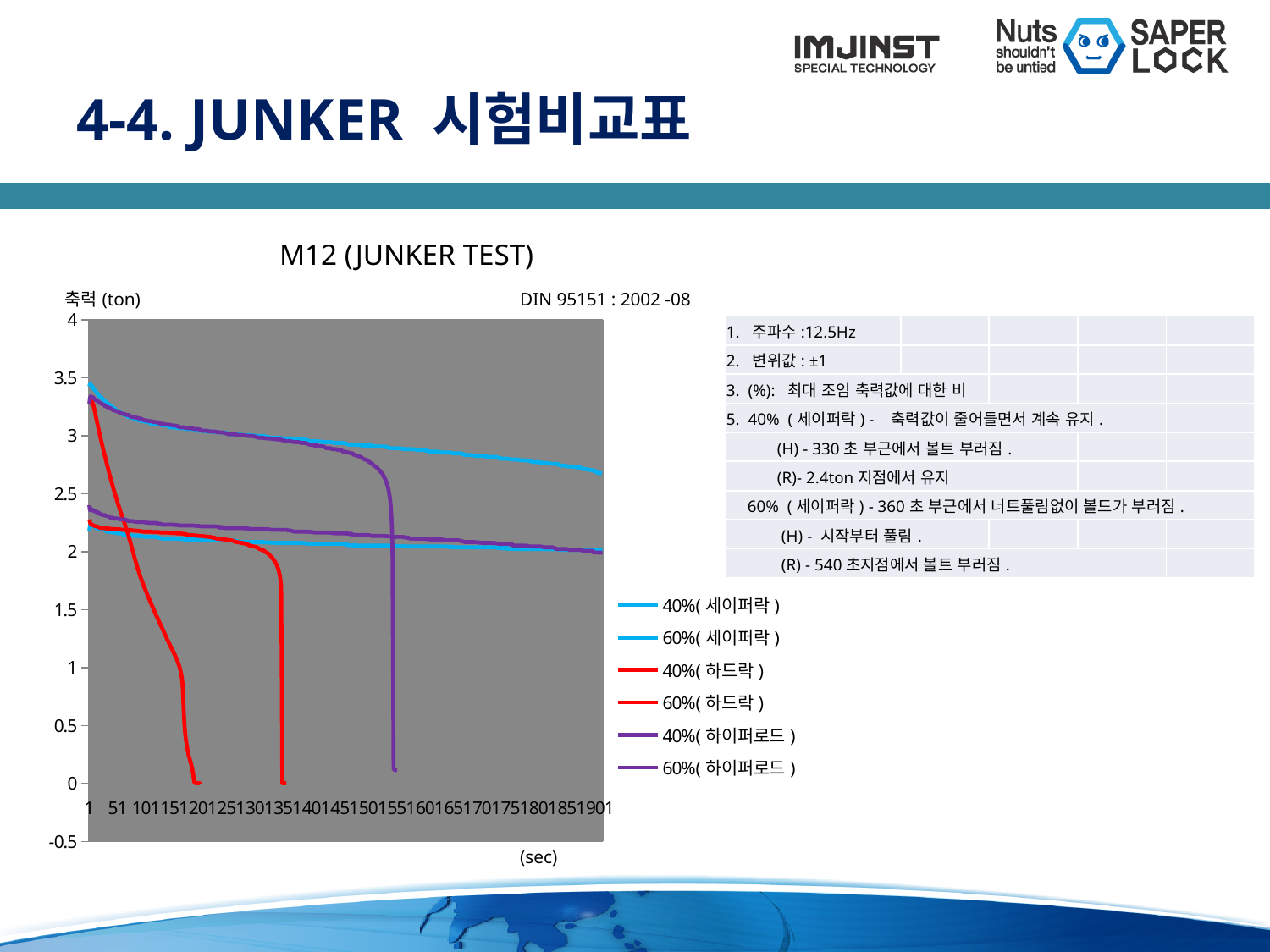
What is the title of the chart? M12 (JUNKER TEST) Is the starting value of the highest line in the chart greater or less than 4? less Is the starting value of the highest line in the chart greater or less than 3? greater Do the plotted lines generally rise or fall as the x axis (sec) increases? fall What kind of chart is shown on the slide? line chart How many series does the legend of the M12 (JUNKER TEST) chart list? 6 What colour are the 40%(하드락) and 60%(하드락) lines in the chart? red What is the last tick value shown on the x axis? 1901 What is the highest tick value shown on the y axis (축력 (ton))? 4 What is the lowest tick value shown on the y axis? -0.5